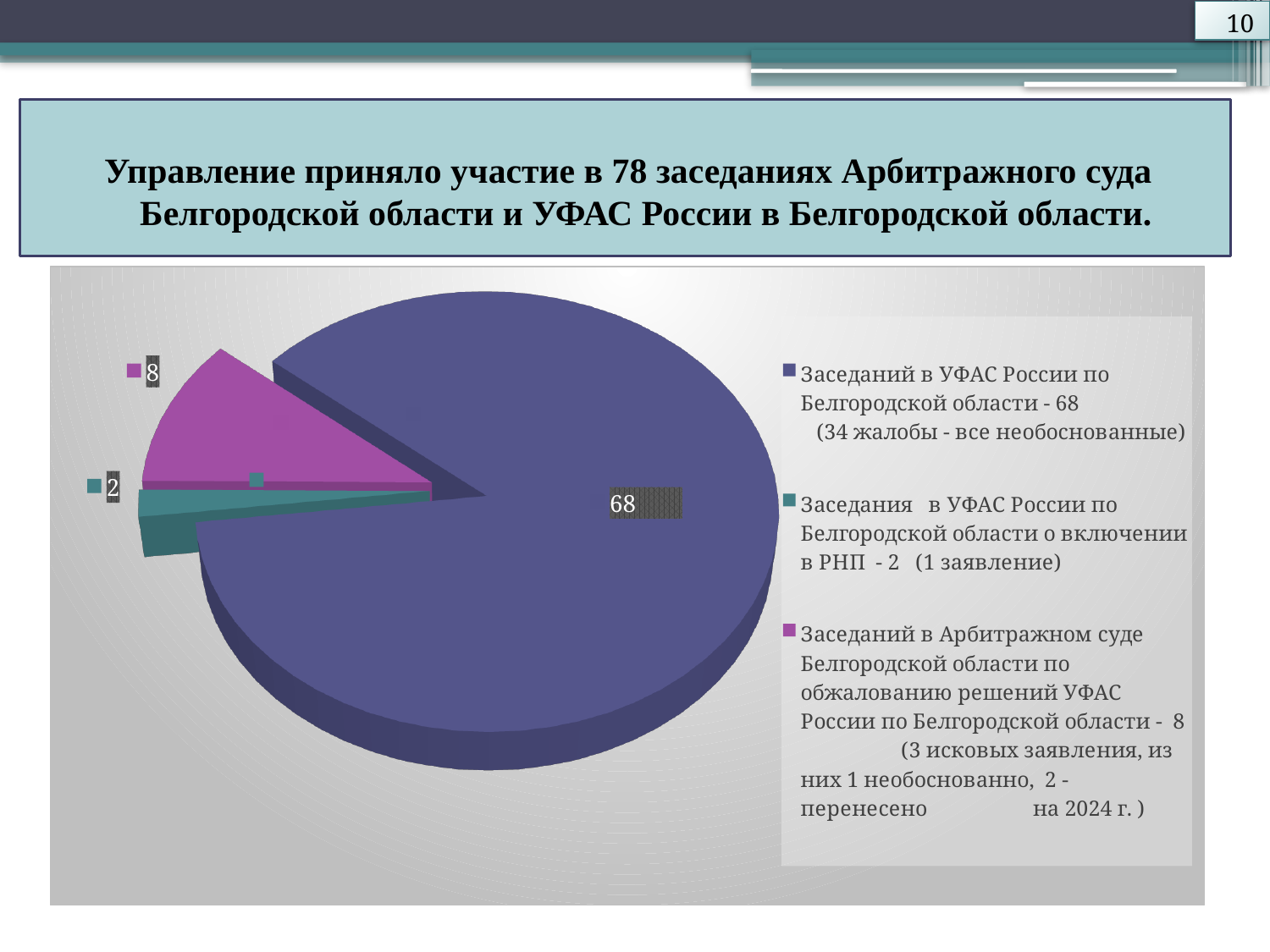
What value is shown for the slice 'Заседаний в Арбитражном суде Белгородской области по обжалованию решений УФАС России по Белгородской области'? 8 What kind of chart is shown on the slide? Pie chart How many slices does the pie chart have? 3 Which category has the largest slice in the pie chart? Заседаний в УФАС России по Белгородской области What is the difference between the value for 'Заседаний в Арбитражном суде Белгородской области' and the value for 'Заседания ... о включении в РНП'? 6 What value is shown for the slice 'Заседания в УФАС России по Белгородской области о включении в РНП'? 2 How many entries does the legend of the pie chart list? 3 What is the total of all three slice values in the pie chart? 78 Which is larger: the value for 'Заседаний в Арбитражном суде Белгородской области' or the value for 'Заседания ... о включении в РНП'? Заседаний в Арбитражном суде Белгородской области What is the difference between the value for 'Заседаний в УФАС России по Белгородской области' and the value for 'Заседаний в Арбитражном суде Белгородской области'? 60 What value is shown for the slice 'Заседаний в УФАС России по Белгородской области'? 68 Which category has the smallest slice in the pie chart? Заседания в УФАС России по Белгородской области о включении в РНП